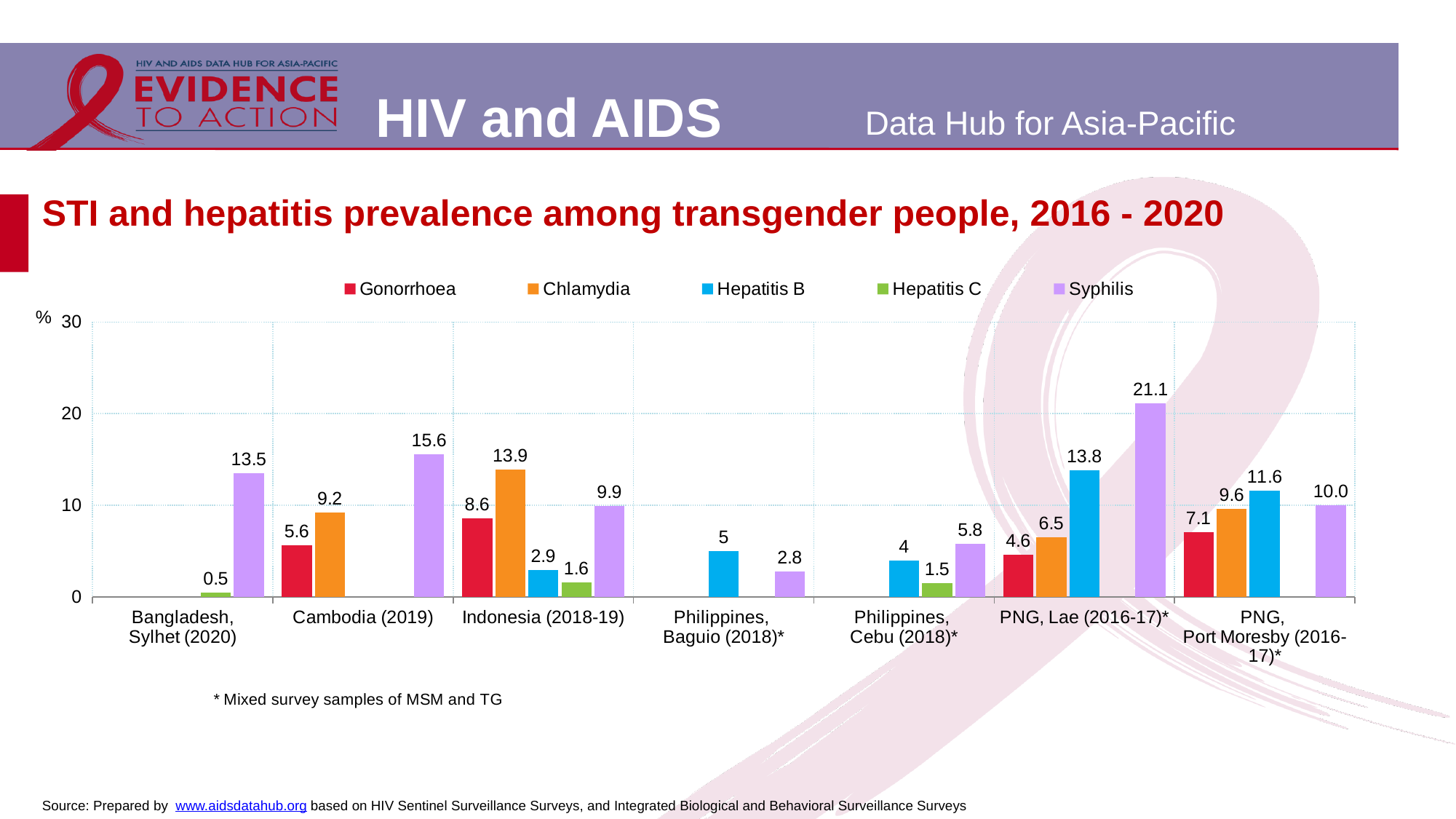
What is the hepatitis C prevalence for Bangladesh, Sylhet (2020)? 0.5 What is the syphilis prevalence for PNG, Lae (2016-17)*? 21.1 What is the difference between the syphilis prevalence in Cambodia (2019) and in Bangladesh, Sylhet (2020)? 2.1 What is the hepatitis B prevalence for PNG, Port Moresby (2016-17)*? 11.6 Which location has the lowest syphilis prevalence? Philippines, Baguio (2018)* Which is larger, the gonorrhoea prevalence in Indonesia (2018-19) or in PNG, Port Moresby (2016-17)*? Indonesia (2018-19) How many series does the legend list? 5 How many locations are shown on the x axis? 7 Which location has the highest syphilis prevalence? PNG, Lae (2016-17)* What kind of chart is shown on the slide? Bar chart What is the chlamydia prevalence for Indonesia (2018-19)? 13.9 Is the hepatitis B prevalence for PNG, Lae (2016-17)* greater or less than 10? greater